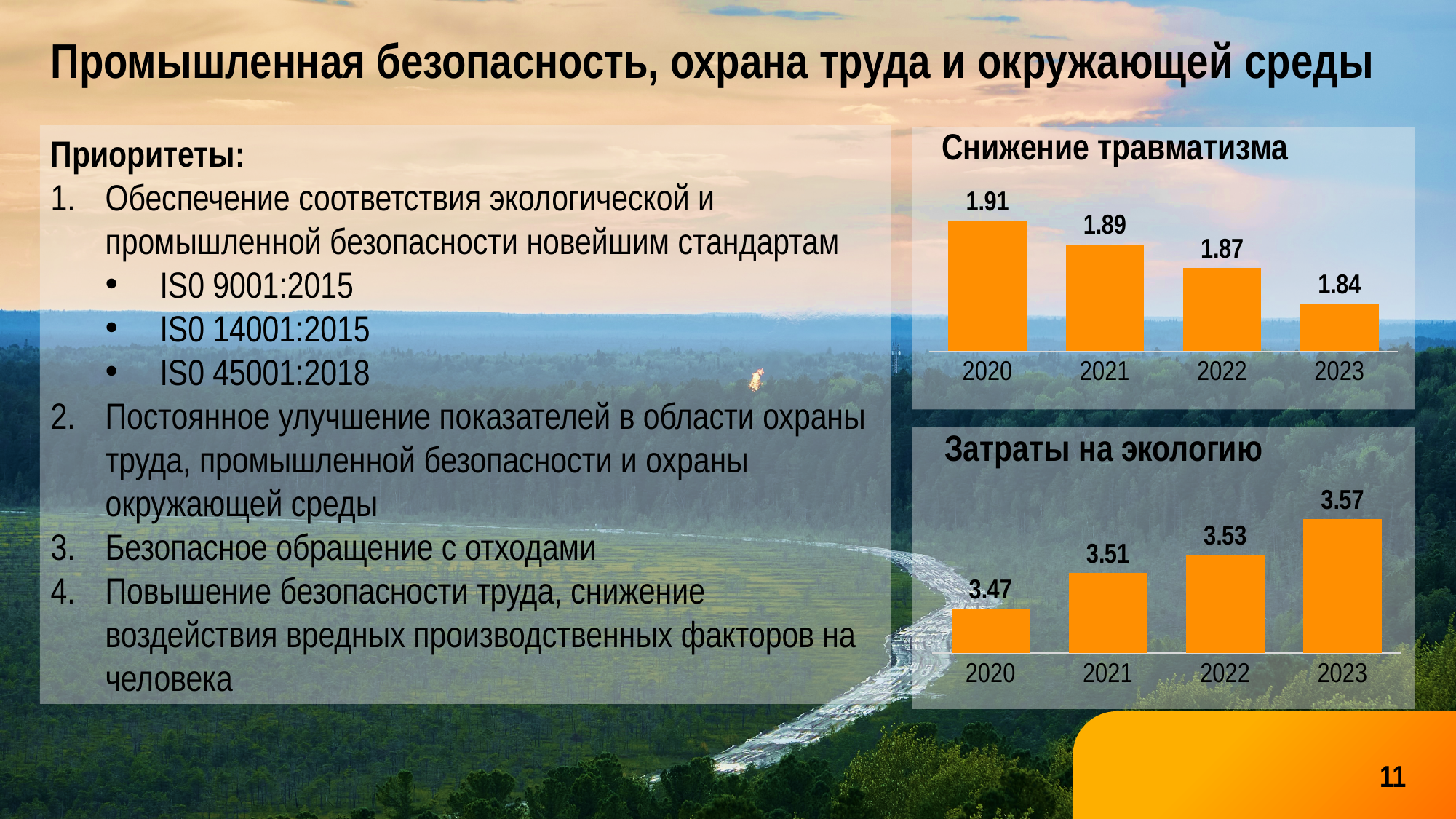
In the 'Затраты на экологию' chart, what is the value for 2023? 3.57 How many years are shown in the 'Затраты на экологию' chart? 4 In the 'Снижение травматизма' chart, do the values rise or fall from 2020 to 2023? fall In the 'Затраты на экологию' chart, what is the difference between the 2023 and 2020 values? 0.10 In the 'Затраты на экологию' chart, which year has the highest value? 2023 What kind of chart is the 'Снижение травматизма' chart? bar chart In the 'Затраты на экологию' chart, which is larger, the value for 2020 or the value for 2022? 2022 In the 'Снижение травматизма' chart, what is the difference between the 2020 and 2023 values? 0.07 In the 'Снижение травматизма' chart, what is the value for 2020? 1.91 In the 'Снижение травматизма' chart, which year has the lowest value? 2023 In the 'Затраты на экологию' chart, what is the value for 2021? 3.51 In the 'Снижение травматизма' chart, what is the value for 2023? 1.84